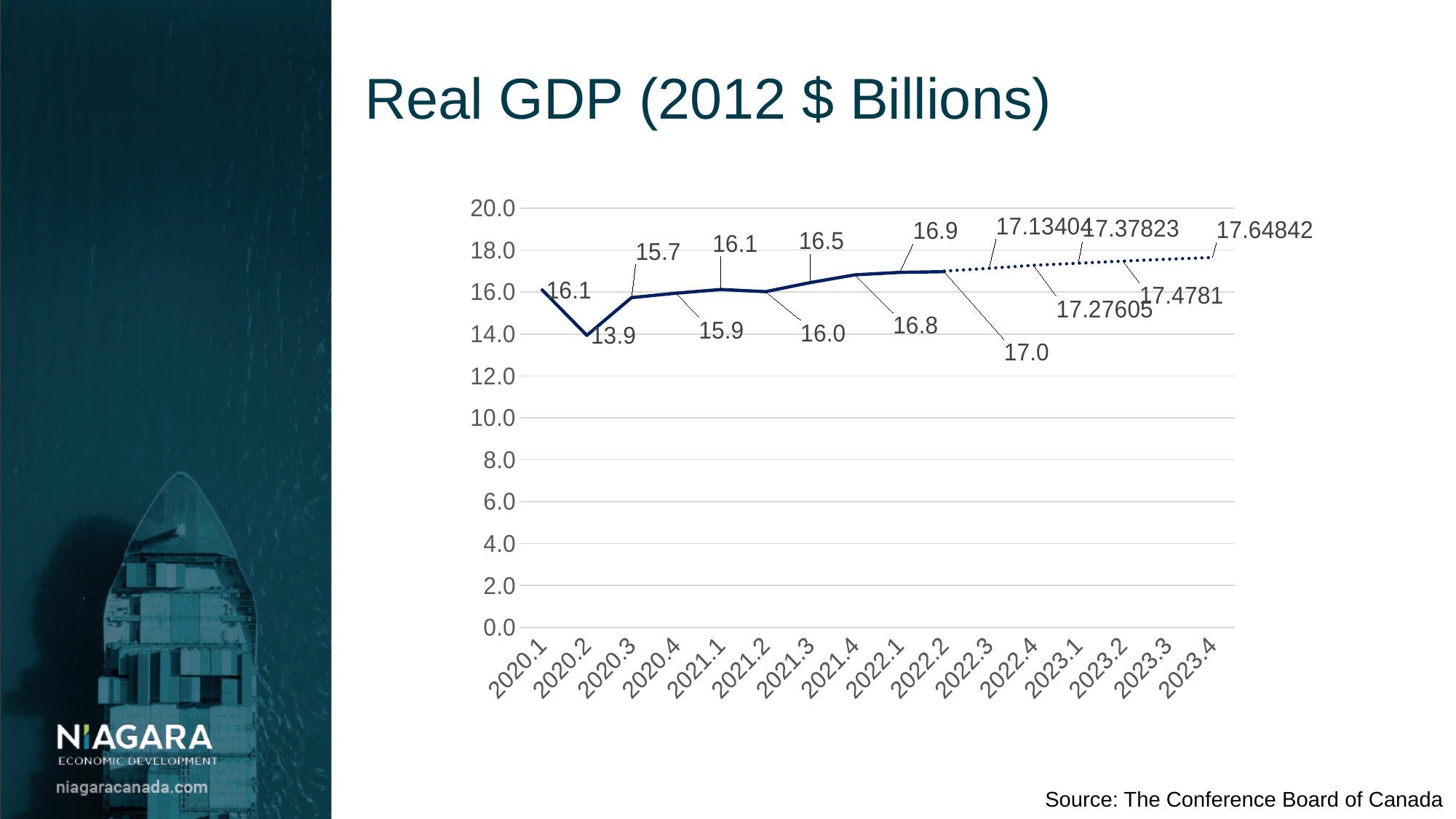
Do the Real GDP values rise or fall from 2020.2 to 2022.2? rise What kind of chart is shown on the slide? line chart Which quarter has the lowest Real GDP value? 2020.2 What is the difference between the Real GDP values for 2020.1 and 2020.2? 2.2 Is the Real GDP value for 2022.4 greater or less than 16.0? greater How many quarters are plotted on the x axis? 16 Which quarter has a higher Real GDP value, 2021.3 or 2021.4? 2021.4 Which quarter has the highest Real GDP value? 2023.4 What is the Real GDP value for 2021.3? 16.5 What is the Real GDP value for 2023.1? 17.37823 What is the Real GDP value for 2022.2? 17.0 What is the Real GDP value for 2020.2? 13.9